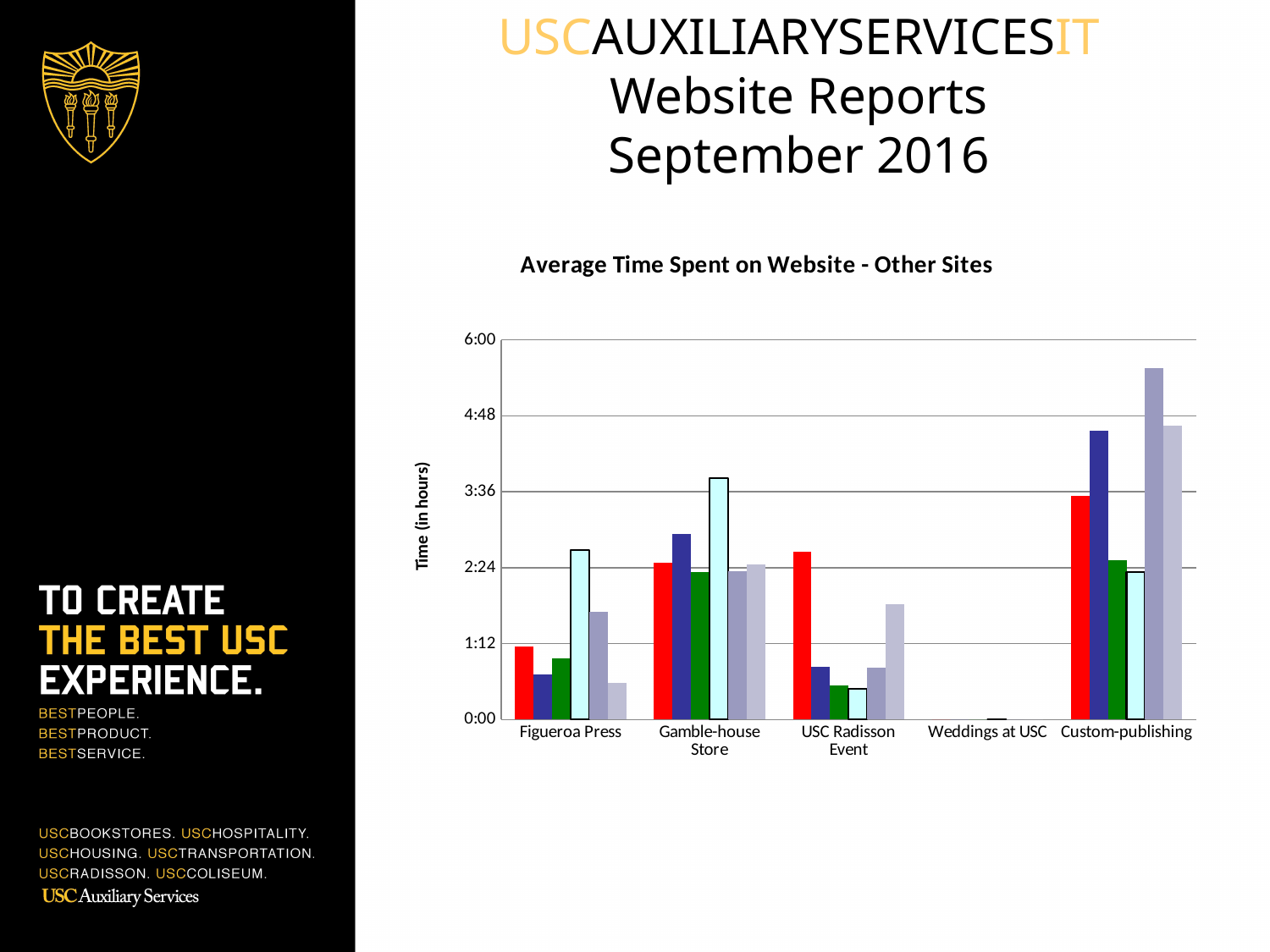
Is the light blue bar for Figueroa Press greater or less than 2:24? greater Which category contains the tallest bar in the chart? Custom-publishing What kind of chart is shown on the slide? bar chart What is the highest value shown on the vertical axis of the chart? 6:00 Which is larger, the red bar for Custom-publishing or the red bar for Figueroa Press? Custom-publishing Is the tallest bar for Custom-publishing greater or less than 4:48? greater What is the title of the chart? Average Time Spent on Website - Other Sites What is the label on the vertical axis of the chart? Time (in hours) How many categories are shown on the x axis of the chart? 5 Which category has the lowest values overall in the chart? Weddings at USC Is the light blue bar for Gamble-house Store greater or less than 3:36? greater